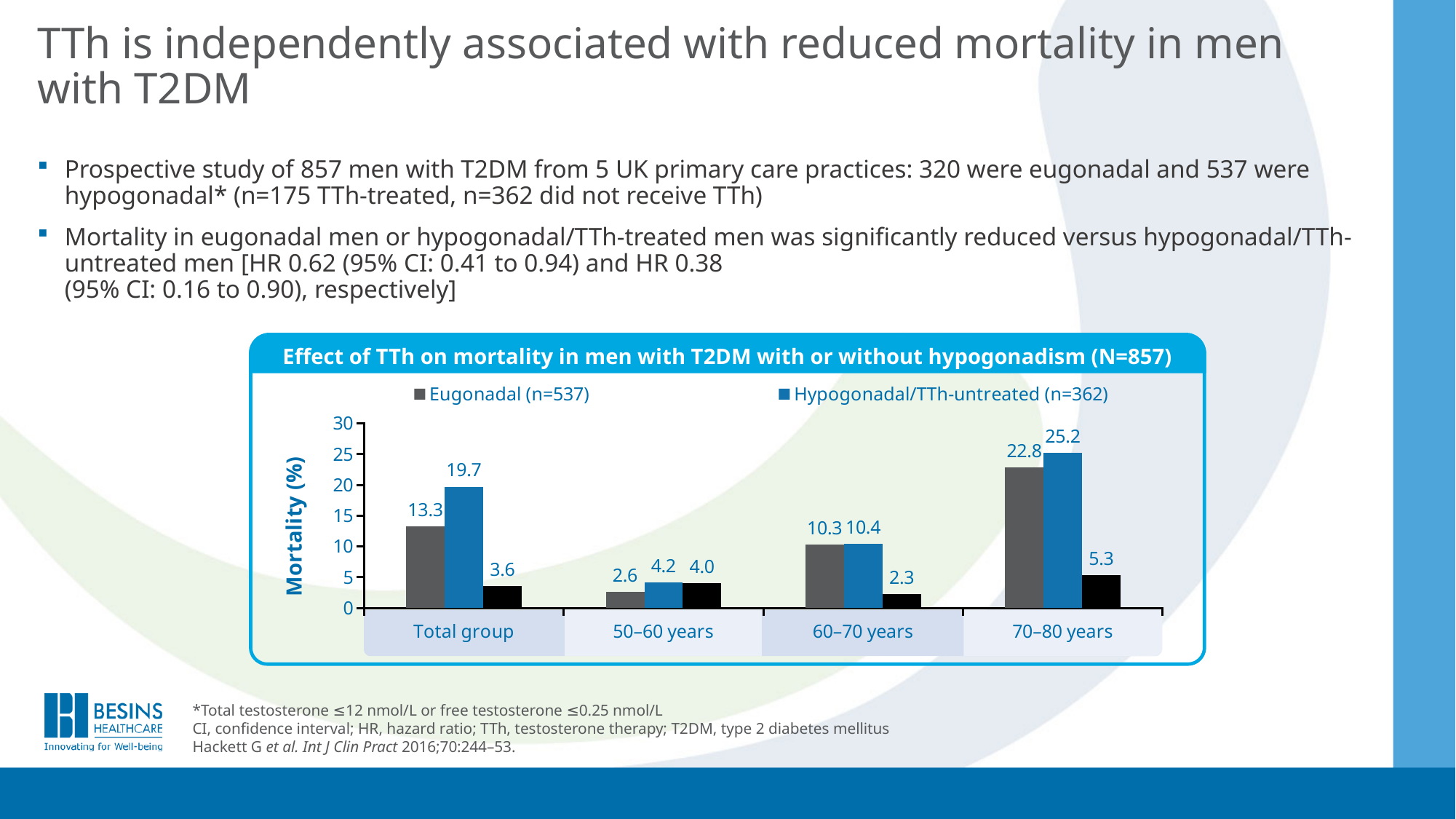
Does the Eugonadal mortality rise or fall from the 50–60 years category to the 70–80 years category? Rise What type of chart is shown on the slide? Bar chart In the 50–60 years category, which has the higher mortality: Eugonadal or Hypogonadal/TTh-untreated? Hypogonadal/TTh-untreated What is the mortality (%) for the Eugonadal group in the Total group category? 13.3 How many series does the chart legend list? 2 In the 70–80 years category, what is the difference between the Hypogonadal/TTh-untreated and Eugonadal mortality values? 2.4 How many categories are shown on the x axis of the chart? 4 What is the mortality (%) for the Hypogonadal/TTh-untreated group in the 70–80 years category? 25.2 In the Total group category, how much higher is the Hypogonadal/TTh-untreated mortality than the Eugonadal mortality? 6.4 What is the mortality (%) for the Eugonadal group in the 60–70 years category? 10.3 In which category is the Hypogonadal/TTh-untreated mortality highest? 70–80 years In which category is the Eugonadal mortality lowest? 50–60 years